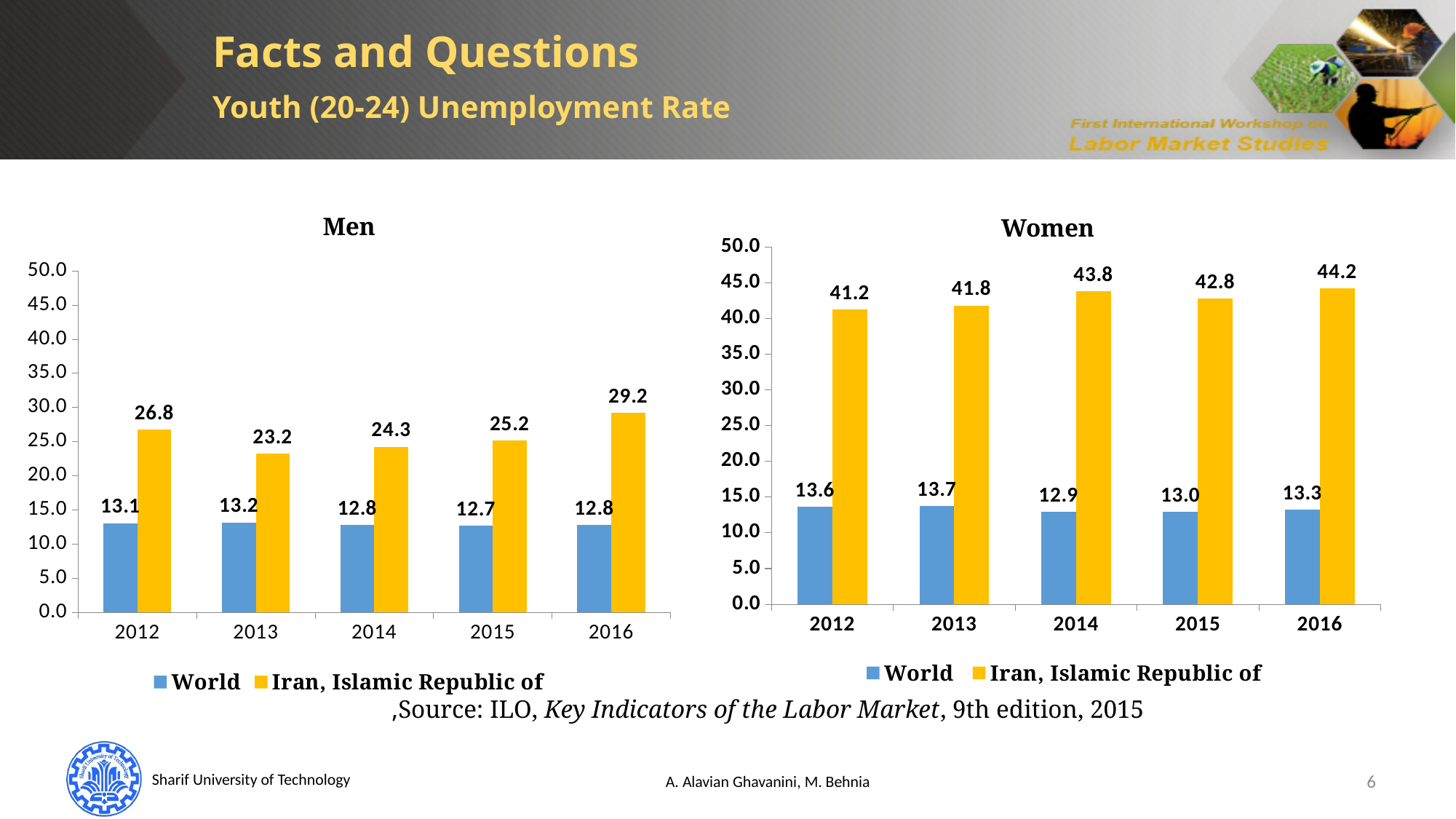
In the Men chart, what is the difference between the Iran, Islamic Republic of value and the World value in 2012? 13.7 In the Men chart, which year has the lowest value for Iran, Islamic Republic of? 2013 In the Women chart, which year has the highest value for Iran, Islamic Republic of? 2016 In the Men chart, what colour are the bars for Iran, Islamic Republic of? yellow How many series does the legend of the Women chart list? 2 In the Men chart, what is the value for Iran, Islamic Republic of in 2016? 29.2 In the Women chart, is the value for Iran, Islamic Republic of in 2012 larger than the value for World in 2012? Yes In the Women chart, what is the difference between the Iran, Islamic Republic of values for 2014 and 2015? 1.0 What kind of chart is the Women chart? bar chart How many years are shown on the x axis of the Men chart? 5 In the Men chart, is the value for Iran, Islamic Republic of in 2016 greater or less than 25.0? greater In the Women chart, what is the value for World in 2013? 13.7